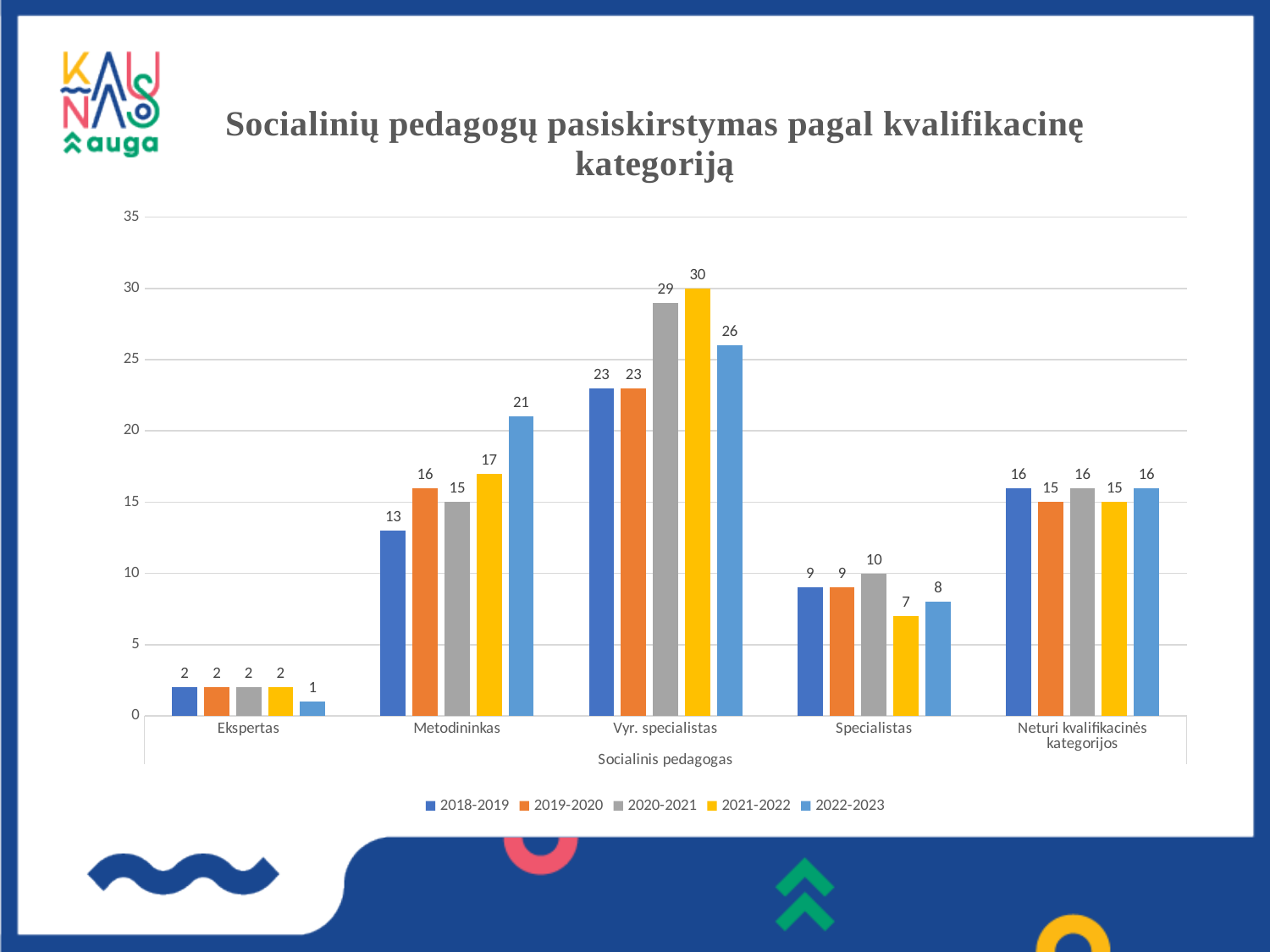
What is the value for Vyr. specialistas in the 2021-2022 series? 30 Which is larger for Specialistas: the 2020-2021 value or the 2021-2022 value? 2020-2021 Which category has the highest value in the 2021-2022 series? Vyr. specialistas What kind of chart is shown on the slide? Bar chart Which category has the lowest value in the 2018-2019 series? Ekspertas What is the value for Ekspertas in the 2022-2023 series? 1 What is the value for Metodininkas in the 2022-2023 series? 21 What is the difference between the 2022-2023 and 2018-2019 values for Metodininkas? 8 How many series does the legend list? 5 How many categories are shown on the x axis? 5 What is the value for Specialistas in the 2020-2021 series? 10 What is the title of the x axis? Socialinis pedagogas